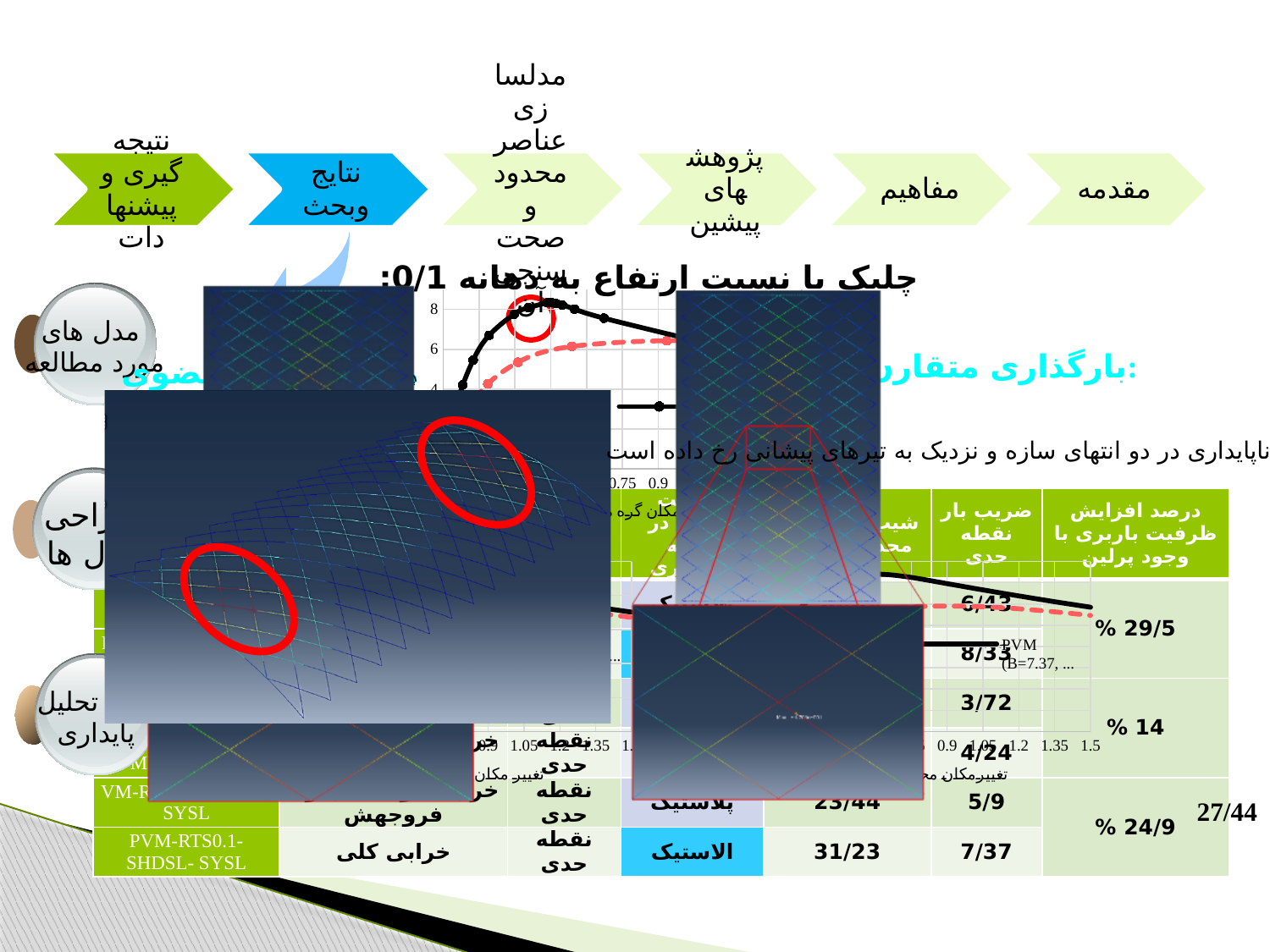
In the upper-middle line chart, does the black solid line rise or fall as it moves to the right after reaching its peak? fall In the upper-middle line chart, what line style is used for the red series? dashed What is the largest x-axis tick value shown on the line chart at the right side of the slide? 1.5 What kind of chart is the partially visible chart in the upper middle of the slide? line chart